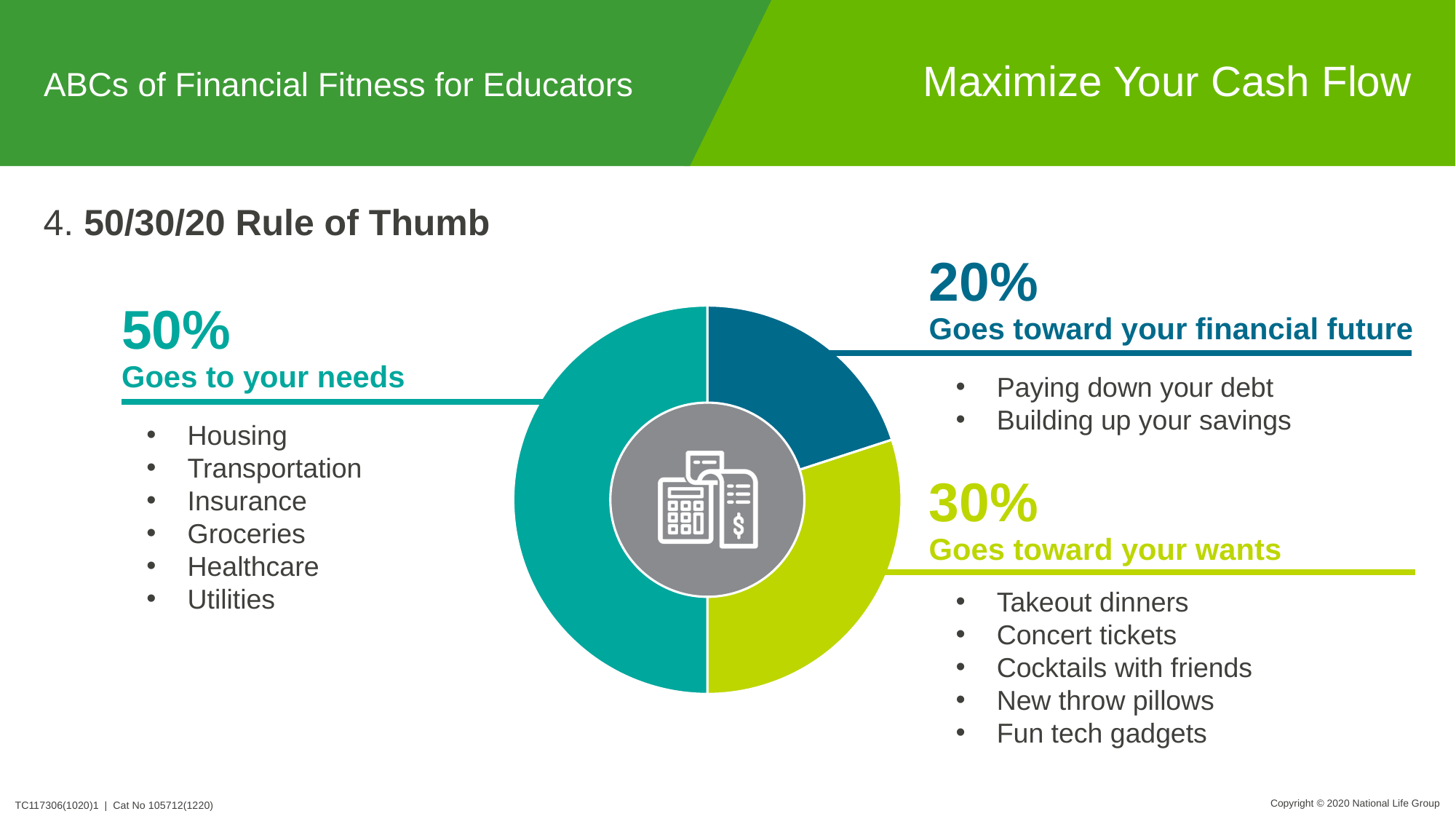
What share of the pie goes to your needs? 50% What is the difference between the needs share and the wants share? 20% What share of the pie goes toward your wants? 30% What share of the pie goes toward your financial future? 20% Which is larger, the share for wants or the share for financial future? Wants (30%) Which slice of the pie is the smallest? Goes toward your financial future (20%) What kind of chart is shown on the slide? Pie chart (doughnut) Which slice of the pie is the largest? Goes to your needs (50%) What rule of thumb does the pie chart illustrate? 50/30/20 Rule of Thumb What colour is the slice representing 50% for needs? Teal What is the difference between the wants share and the financial future share? 10% How many slices does the pie chart have? 3